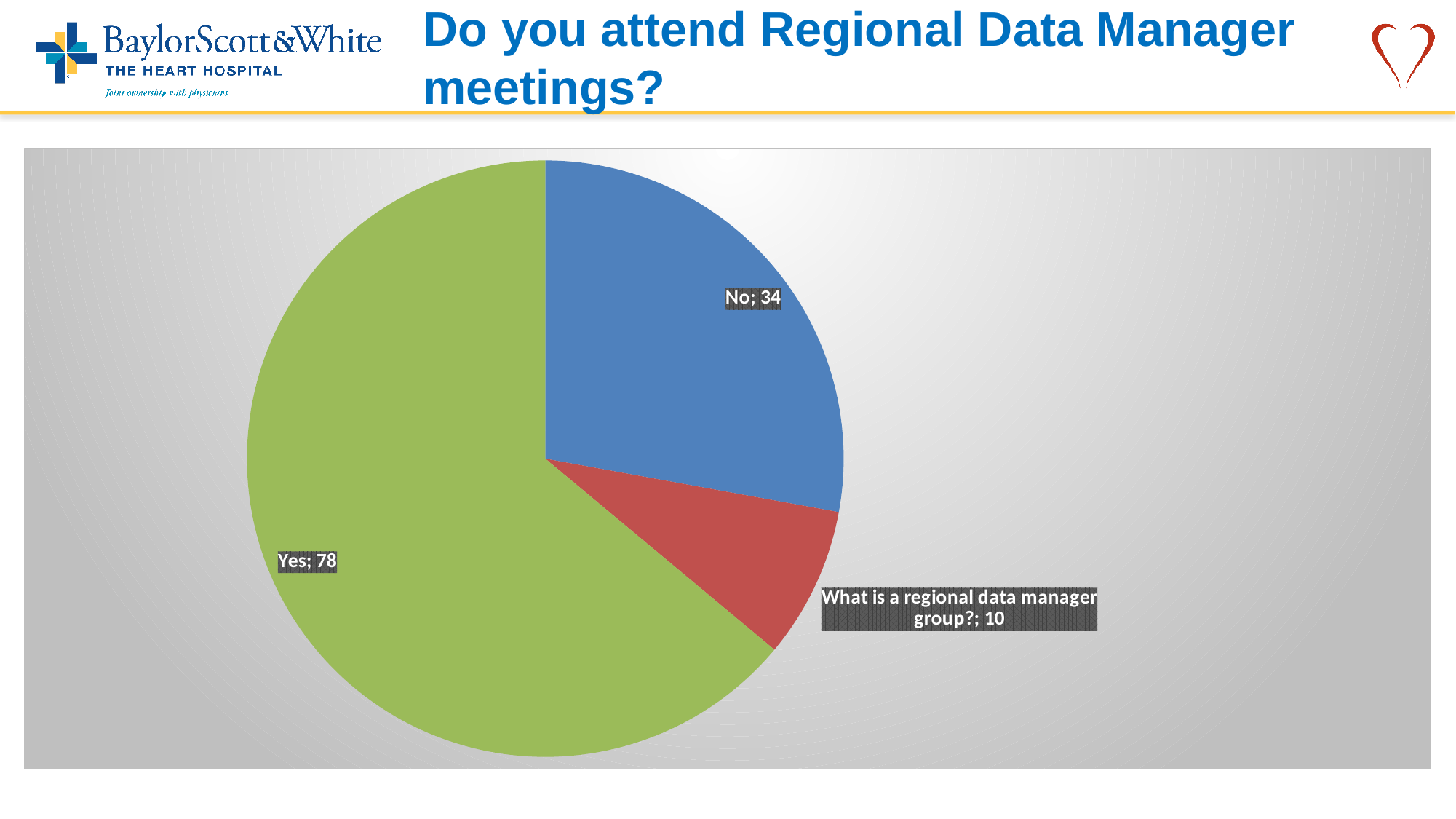
What is the title of the slide containing the pie chart? Do you attend Regional Data Manager meetings? What is the difference between the "Yes" and "No" values? 44 How many slices does the pie chart have? 3 What is the total of all three slices? 122 What is the value for the "No" slice? 34 Which response has the largest slice? Yes What is the value for the "Yes" slice? 78 What kind of chart is shown on the slide? pie chart Which response has the smallest slice? What is a regional data manager group? What is the value for the "What is a regional data manager group?" slice? 10 Which is larger, the "No" value or the "What is a regional data manager group?" value? No What colour is the "Yes" slice? green